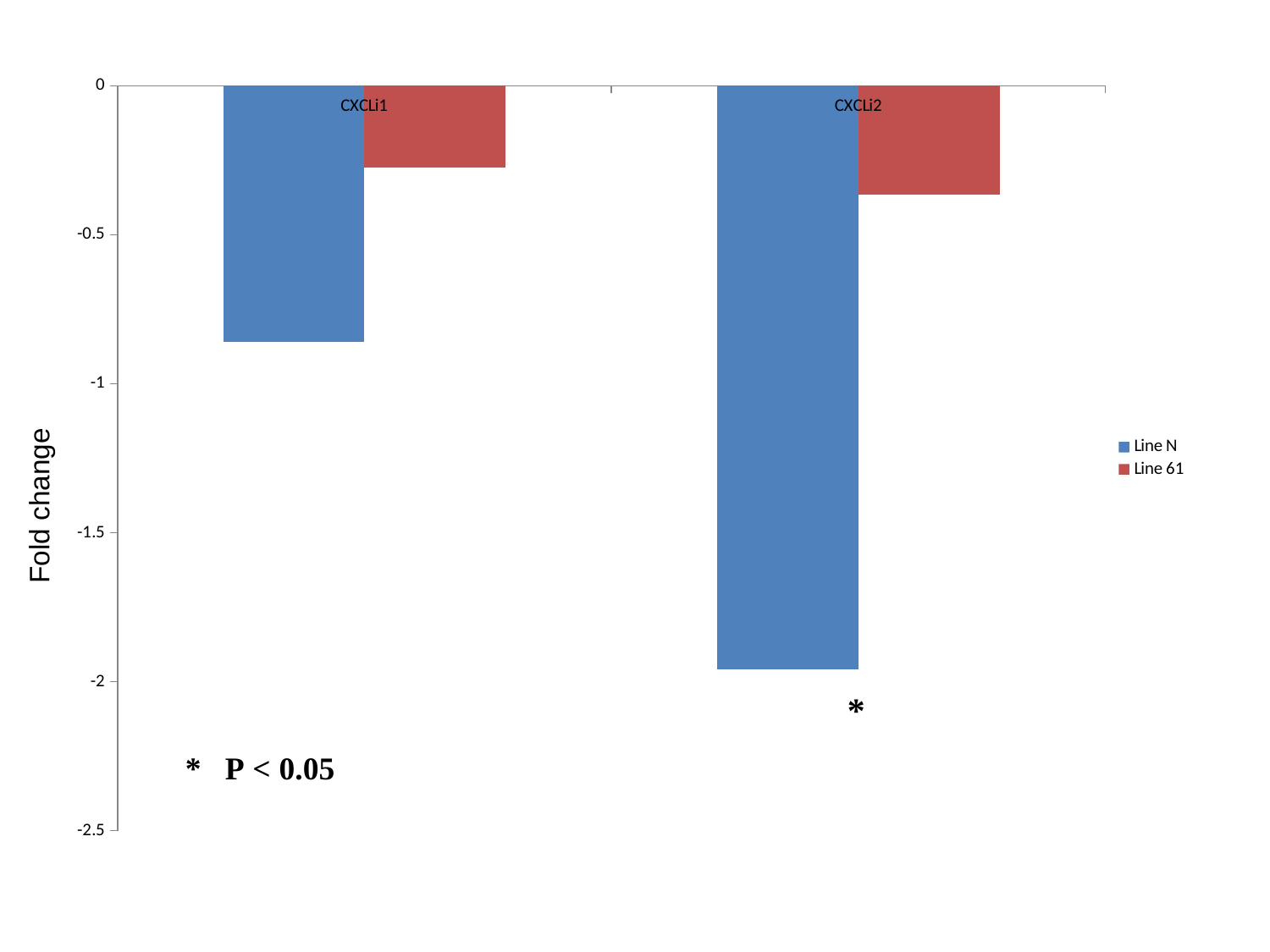
Is the value for Line N at CXCLi2 greater or less than -1.5? less What is the label of the y axis? Fold change How many categories are plotted on the x axis? 2 What kind of chart is shown on the slide? bar chart Is the value for Line N at CXCLi1 greater or less than -0.5? less Which bar has the lowest (most negative) fold change on the chart? Line N at CXCLi2 What are the two series named in the legend? Line N and Line 61 Is the value for Line 61 at CXCLi2 greater or less than -0.5? greater How many series does the legend list? 2 For Line N, which category has the lower (more negative) fold change, CXCLi1 or CXCLi2? CXCLi2 Which bar has the highest fold change (closest to zero) on the chart? Line 61 at CXCLi1